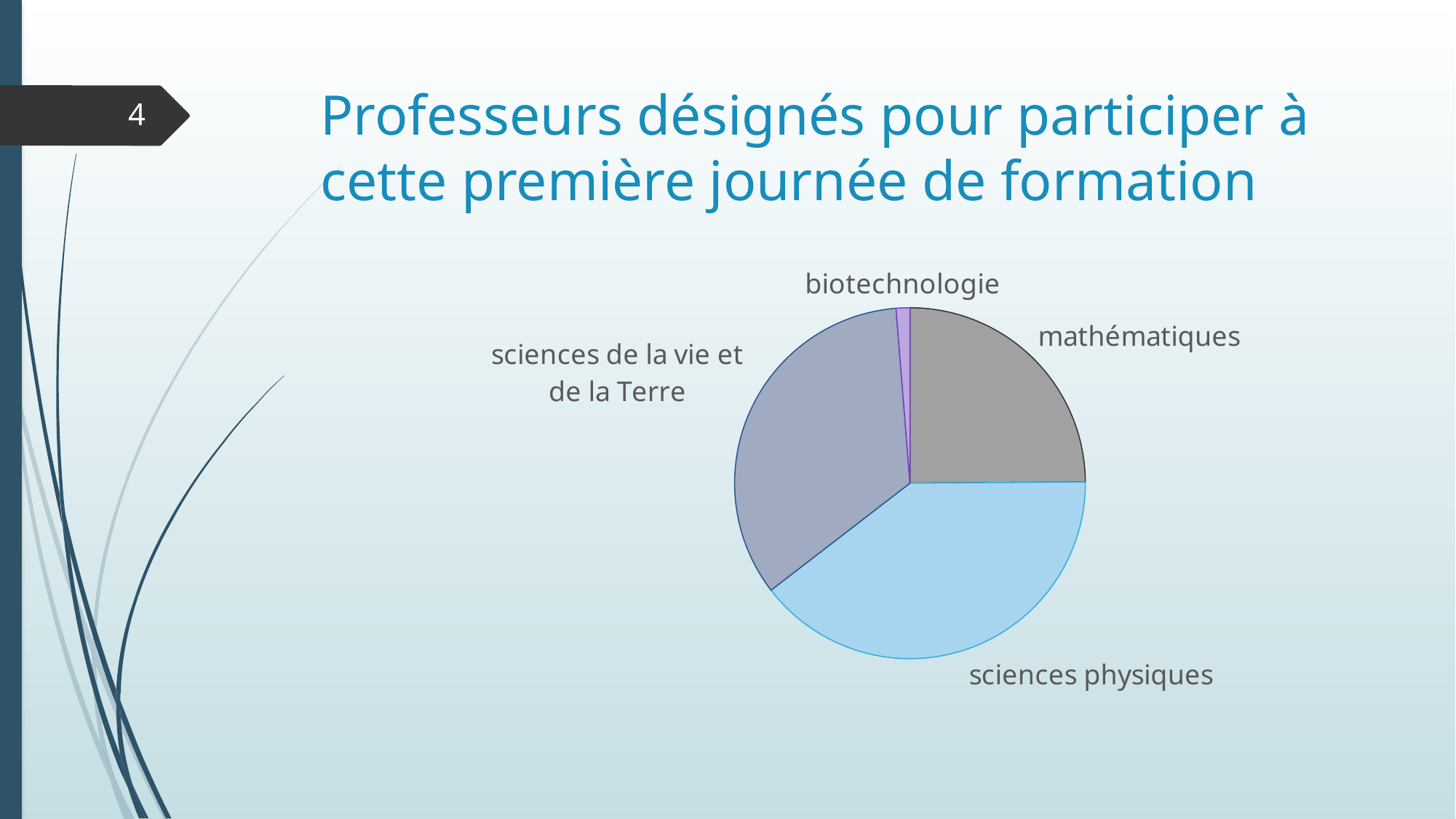
Which slice is larger, sciences de la vie et de la Terre or mathématiques? sciences de la vie et de la Terre What kind of chart is shown on the slide? pie chart Which category has the smallest slice of the pie chart? biotechnologie What is the title of the slide containing the pie chart? Professeurs désignés pour participer à cette première journée de formation Which category has the largest slice of the pie chart? sciences physiques Which slice is larger, biotechnologie or mathématiques? mathématiques How many slices does the pie chart have? 4 Which category is shown in light blue on the pie chart? sciences physiques Which slice is larger, sciences physiques or mathématiques? sciences physiques